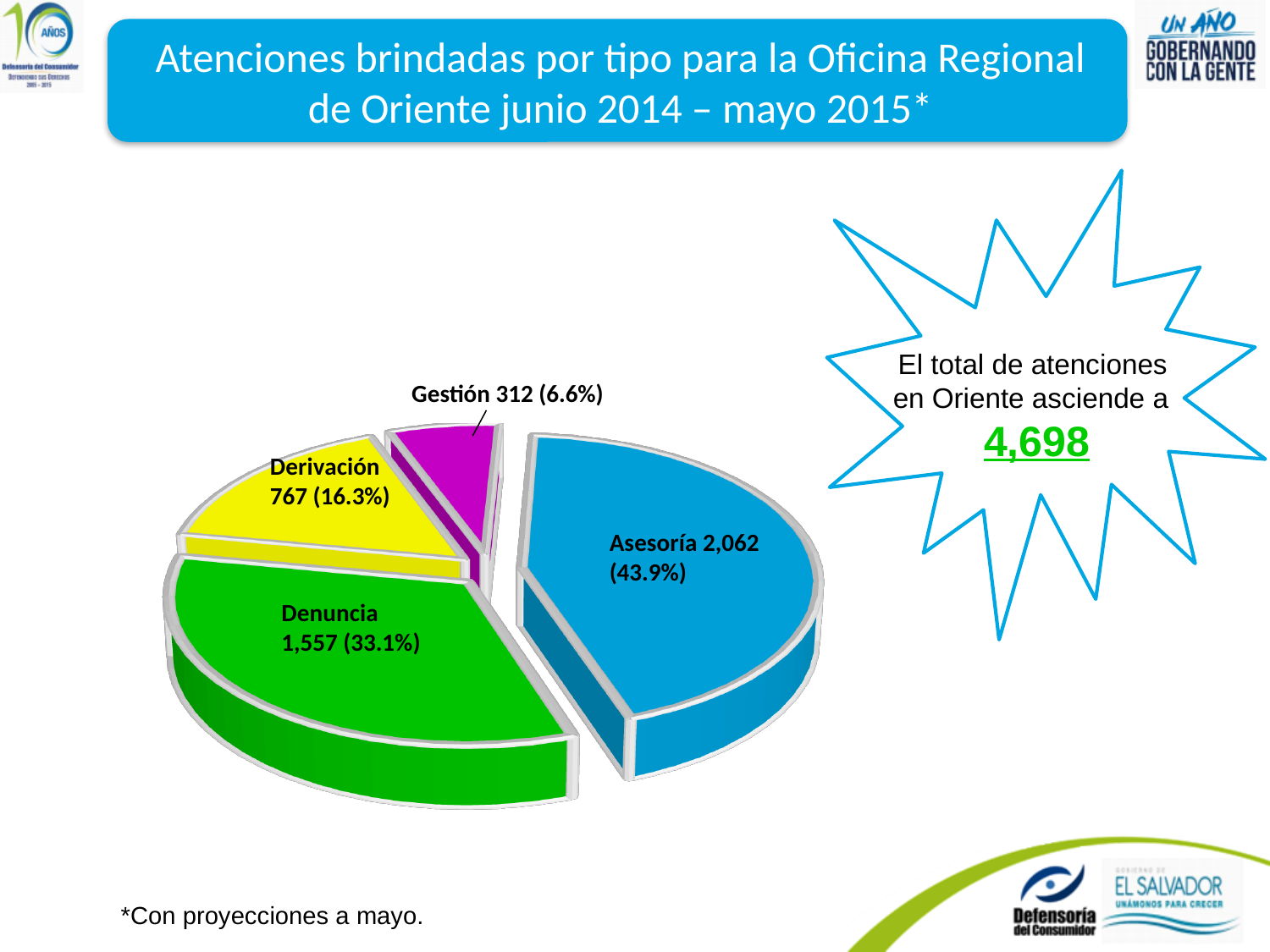
Which colour is the Denuncia slice? Green What is the value for Asesoría? 2,062 What is the value for Derivación? 767 What share of the pie does Derivación represent? 16.3% What is the difference between the values for Asesoría and Denuncia? 505 Which category has the largest slice? Asesoría Which category has the smallest slice? Gestión How many slices does the pie chart have? 4 What is the value for Denuncia? 1,557 What share of the pie does Denuncia represent? 33.1% What is the value for Gestión? 312 What kind of chart is shown on the slide? Pie chart